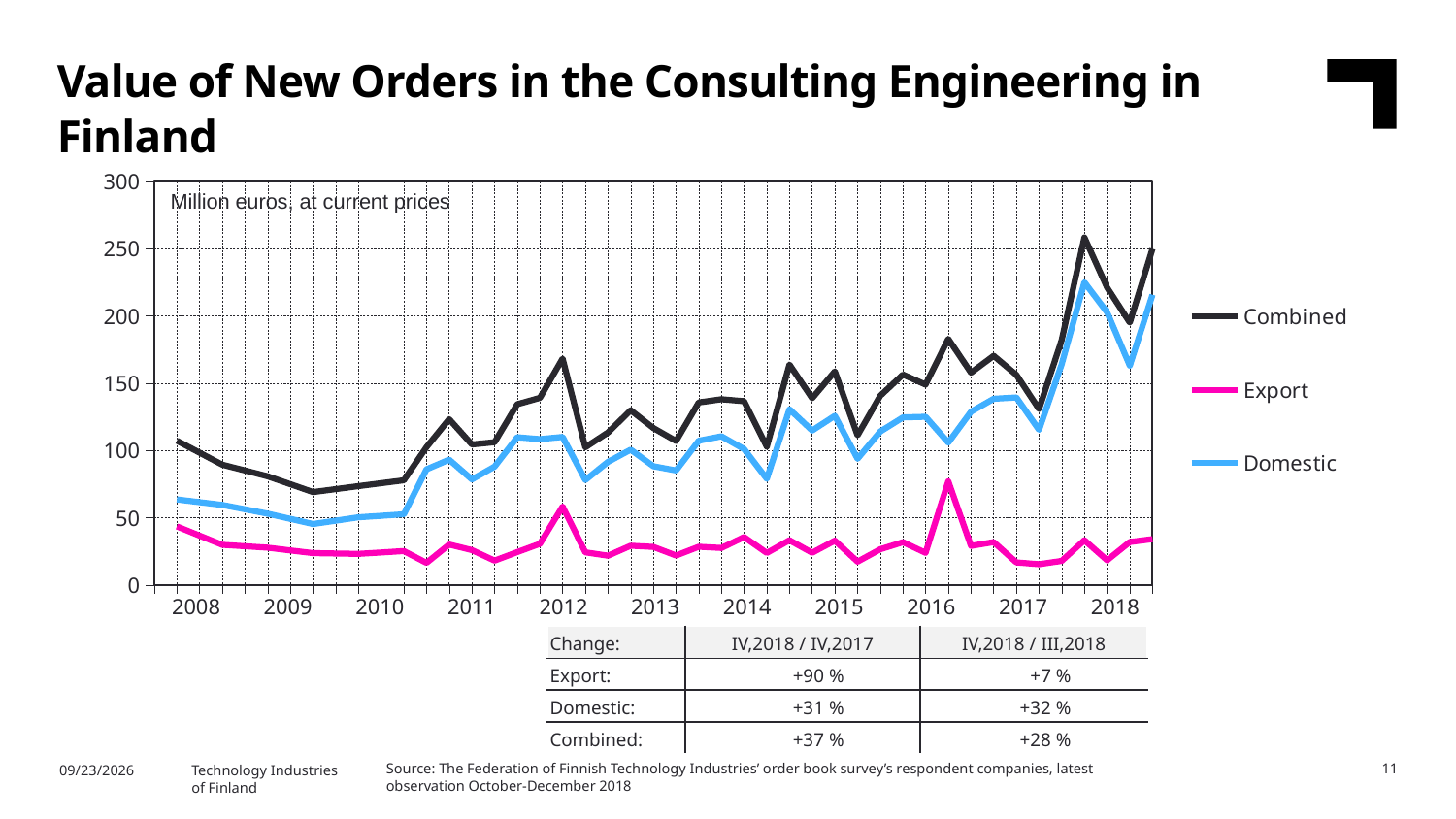
Is the last plotted value of the Combined series in 2018 greater or less than 200? greater What unit label is printed inside the plot area? Million euros, at current prices Is the peak value of the Export series in 2016 greater or less than 50? greater Which series has the lowest values throughout the chart? Export In 2010, which is larger, the Domestic series or the Export series? Domestic How many series does the legend list? 3 What kind of chart is shown on the slide? line chart Is the value of the Combined series at the start of 2009 greater or less than 100? less What are the three series named in the legend? Combined, Export, Domestic Which series has the highest values throughout the chart? Combined Does the Combined series overall rise or fall from 2008 to 2018? rise